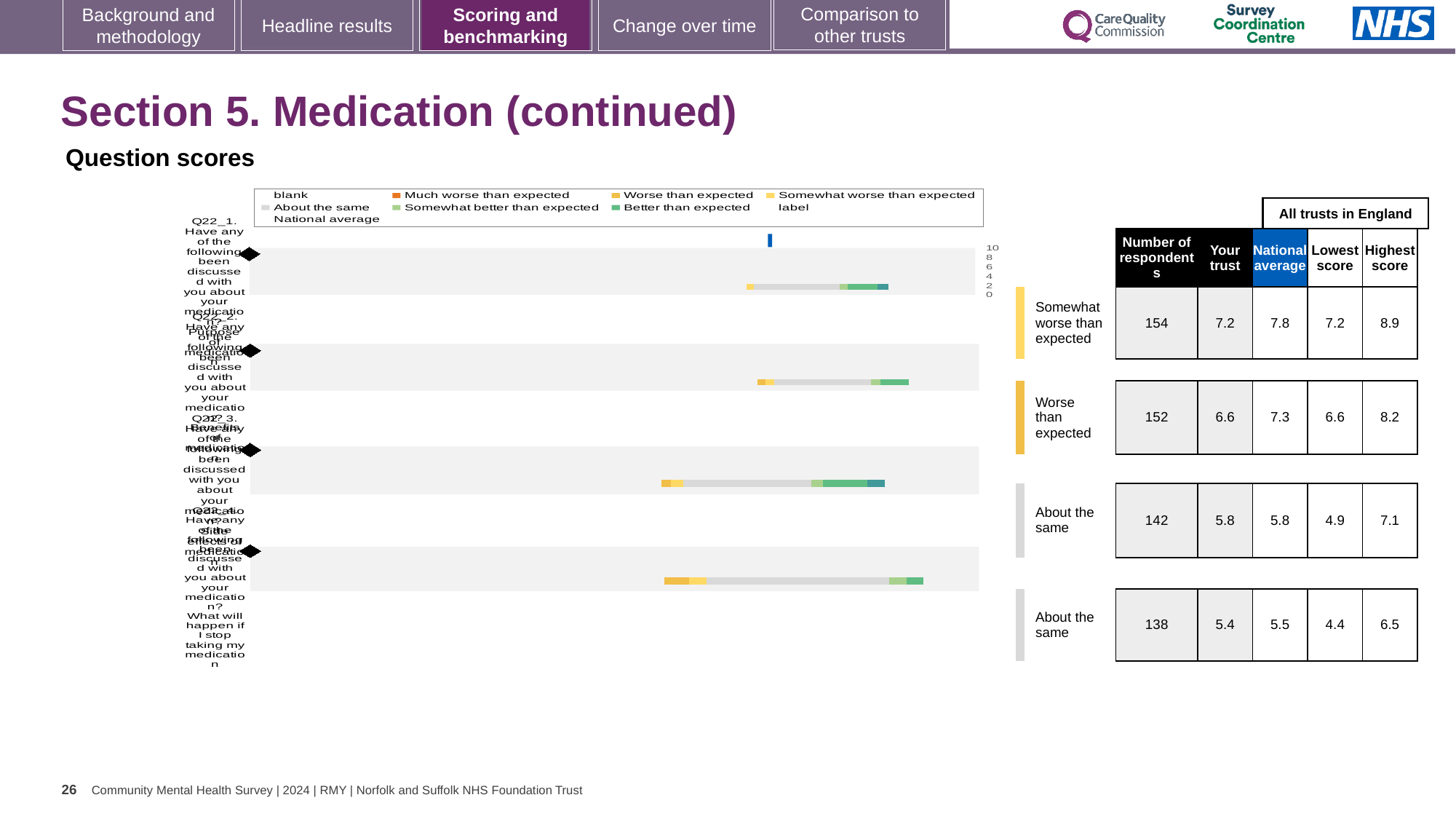
What kind of chart is shown under 'Question scores'? bar chart How many question rows are plotted in the chart? 4 In the table, what is the lowest score for the fourth question row (138 respondents)? 4.4 Which question row has the lowest number of respondents? the fourth row (138) Which benchmark category is shown for the second question row? Worse than expected In the table, what is the number of respondents for the first question row? 154 In the table, what is the highest score across all trusts in England for the first question row? 8.9 Which legend entry is shown in orange? Much worse than expected What is the difference between the national average and the 'Your trust' score for the second question row? 0.7 For the fourth question row, which is larger: the 'Your trust' score or the national average? National average Which question row has the highest 'Your trust' score in the table? the first row (7.2) In the table, what is the 'Your trust' score for the second question row (152 respondents)? 6.6